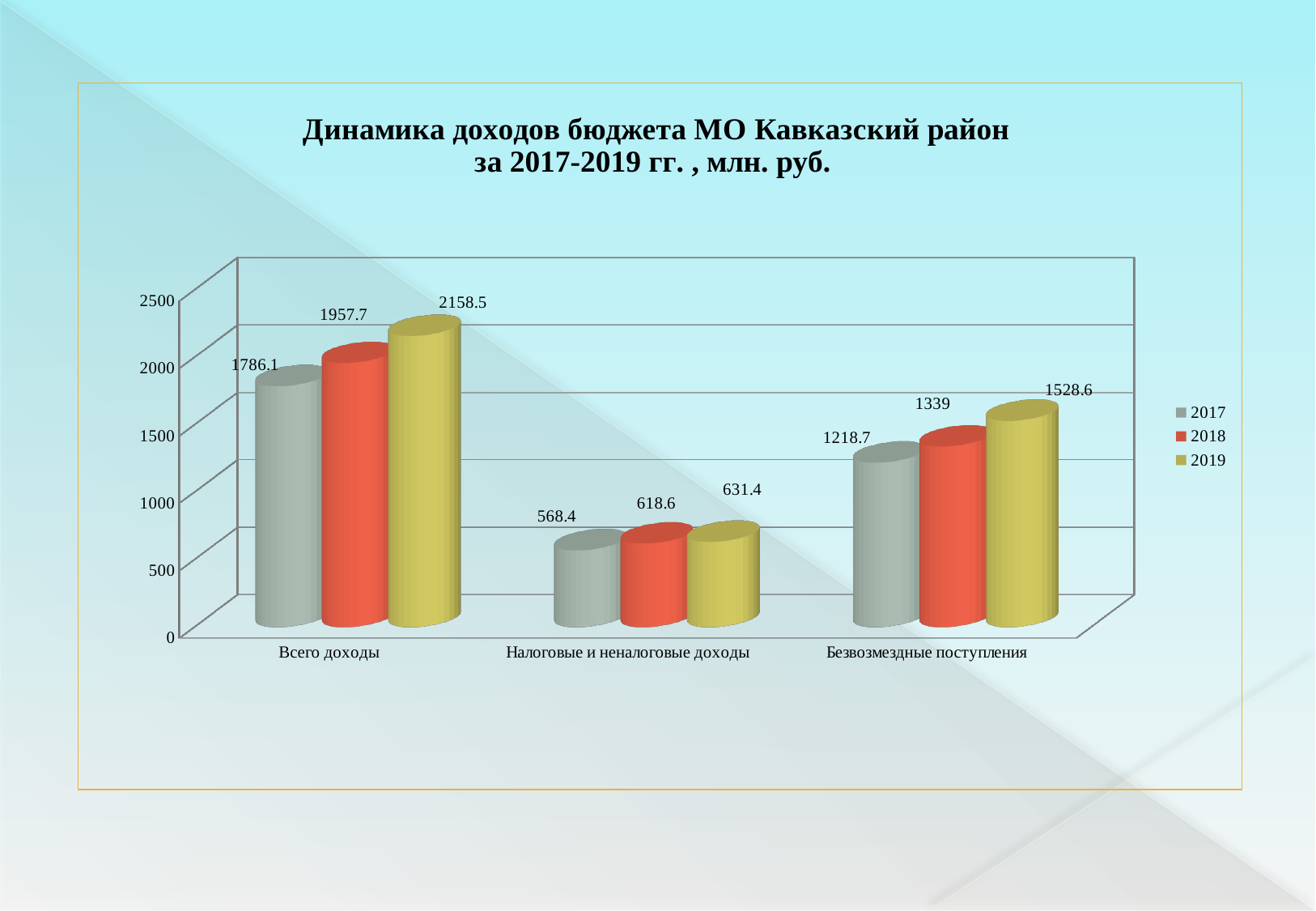
How many series does the legend list? 3 Which year has the highest value for Безвозмездные поступления? 2019 What is the value for Безвозмездные поступления in 2018? 1339 Is the value for Всего доходы in 2018 greater or less than 2000? less Do the values for Всего доходы rise or fall from 2017 to 2019? rise Which is larger: Безвозмездные поступления in 2017 or Налоговые и неналоговые доходы in 2019? Безвозмездные поступления in 2017 What is the value for Всего доходы in 2019? 2158.5 What is the difference between the 2019 and 2017 values for Всего доходы? 372.4 How many categories are shown on the x axis? 3 What is the difference between the 2019 and 2017 values for Безвозмездные поступления? 309.9 Which category has the lowest value in 2019? Налоговые и неналоговые доходы What is the value for Налоговые и неналоговые доходы in 2017? 568.4